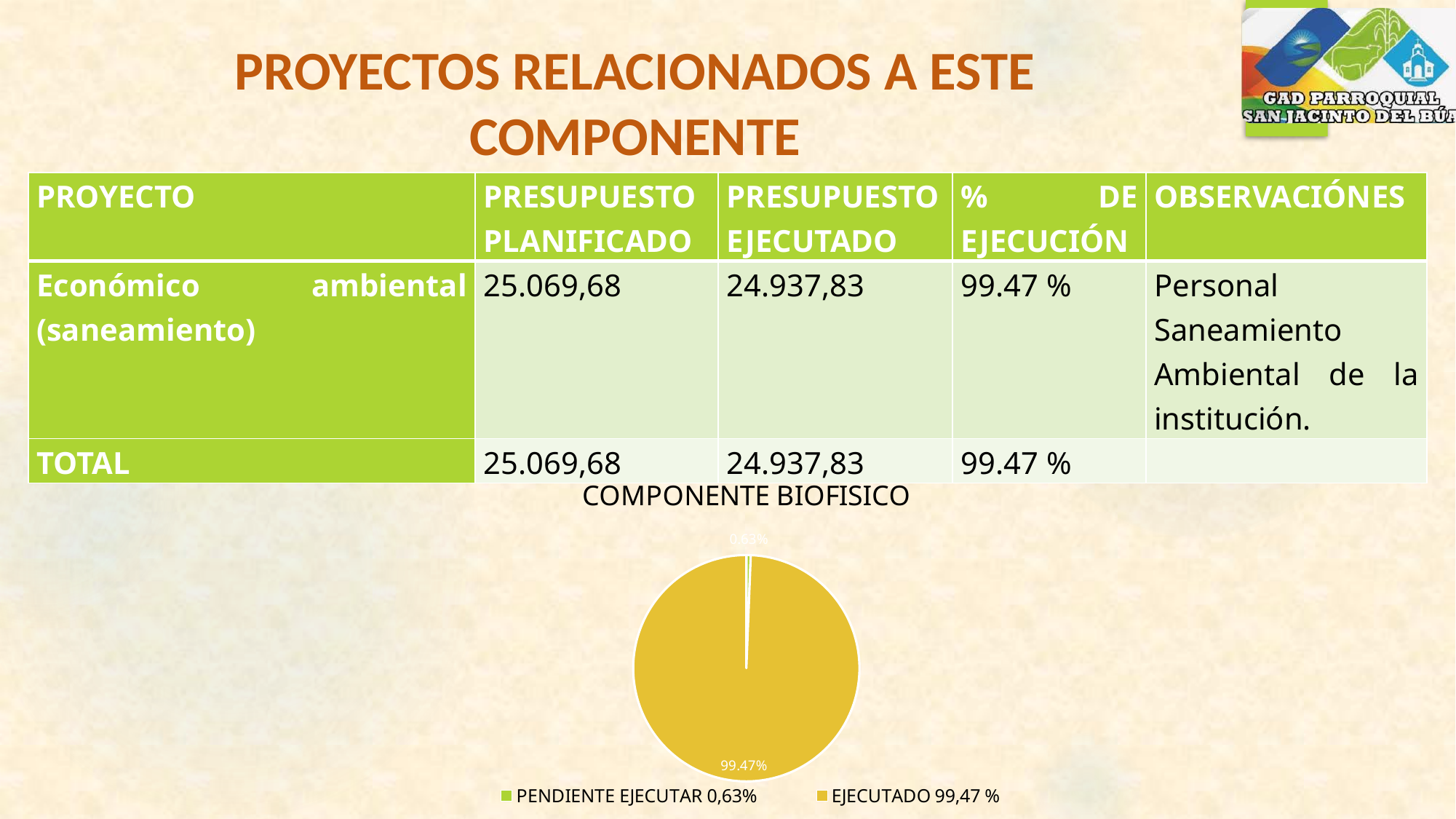
What is the title of the chart on the slide? COMPONENTE BIOFISICO What is the difference in percentage points between the EJECUTADO slice and the PENDIENTE EJECUTAR slice? 98,84% What kind of chart is shown on the slide? pie chart Which slice of the pie chart is the largest? EJECUTADO What percentage is shown for EJECUTADO in the pie chart? 99,47% Which slice of the pie chart is the smallest? PENDIENTE EJECUTAR How many entries does the chart legend list? 2 What percentage is shown for PENDIENTE EJECUTAR in the pie chart? 0,63% How many slices does the pie chart have? 2 What colour is the EJECUTADO slice in the pie chart? yellow Which is larger in the pie chart, EJECUTADO or PENDIENTE EJECUTAR? EJECUTADO